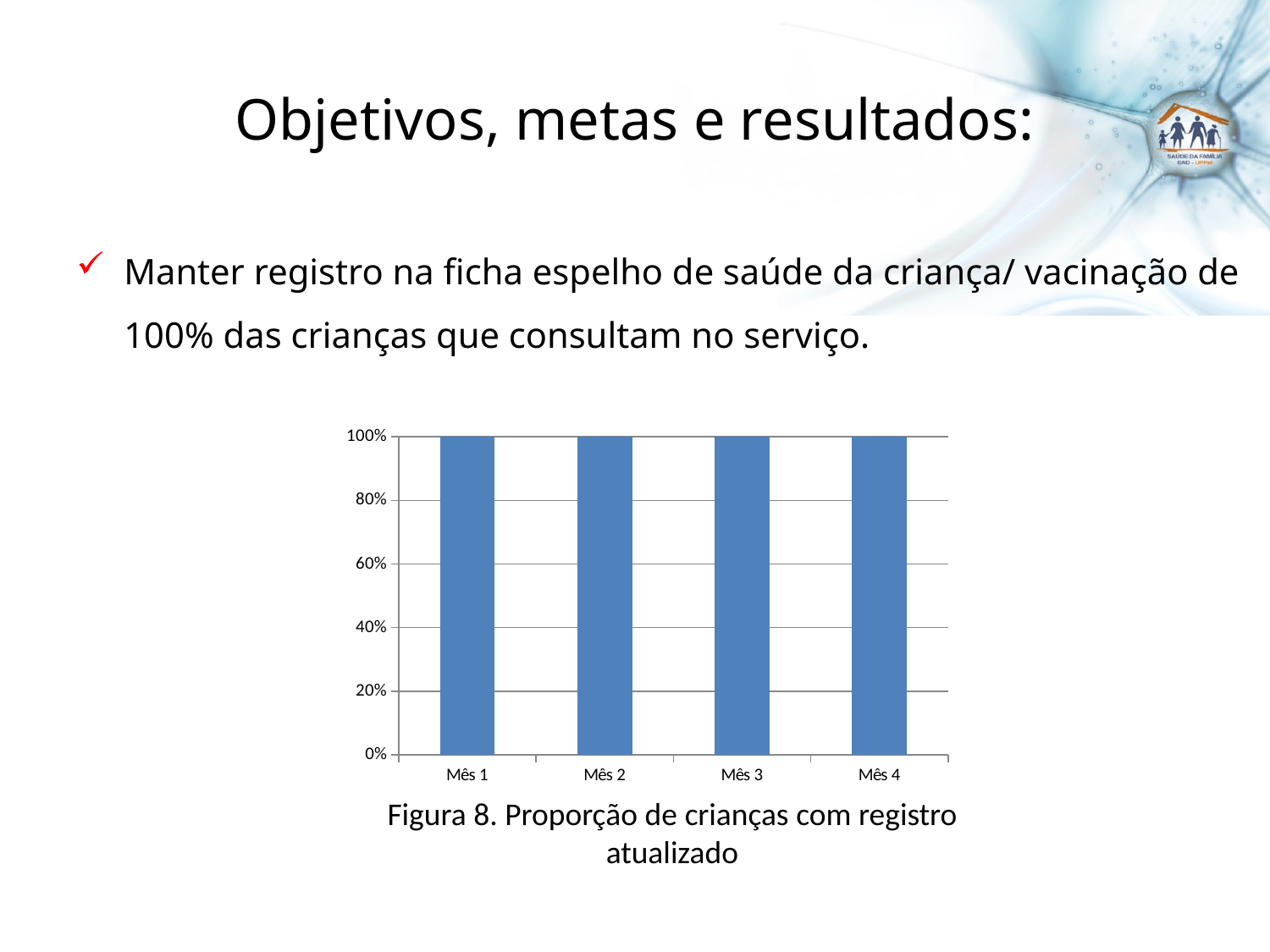
What is the difference between the values for Mês 1 and Mês 4? 0% What is the caption (figure title) of the chart? Figura 8. Proporção de crianças com registro atualizado What is the highest value shown on the y axis of the chart? 100% Is the value for Mês 4 greater or less than 60%? greater What is the value for Mês 1 in the chart? 100% Is the value for Mês 2 greater or less than 80%? greater How many categories (months) are shown on the x axis of the chart? 4 What is the value for Mês 3 in the chart? 100% What kind of chart is shown on the slide? Bar chart Do the values rise, fall, or stay the same from Mês 1 to Mês 4? Stay the same What is the value for Mês 4 in the chart? 100%